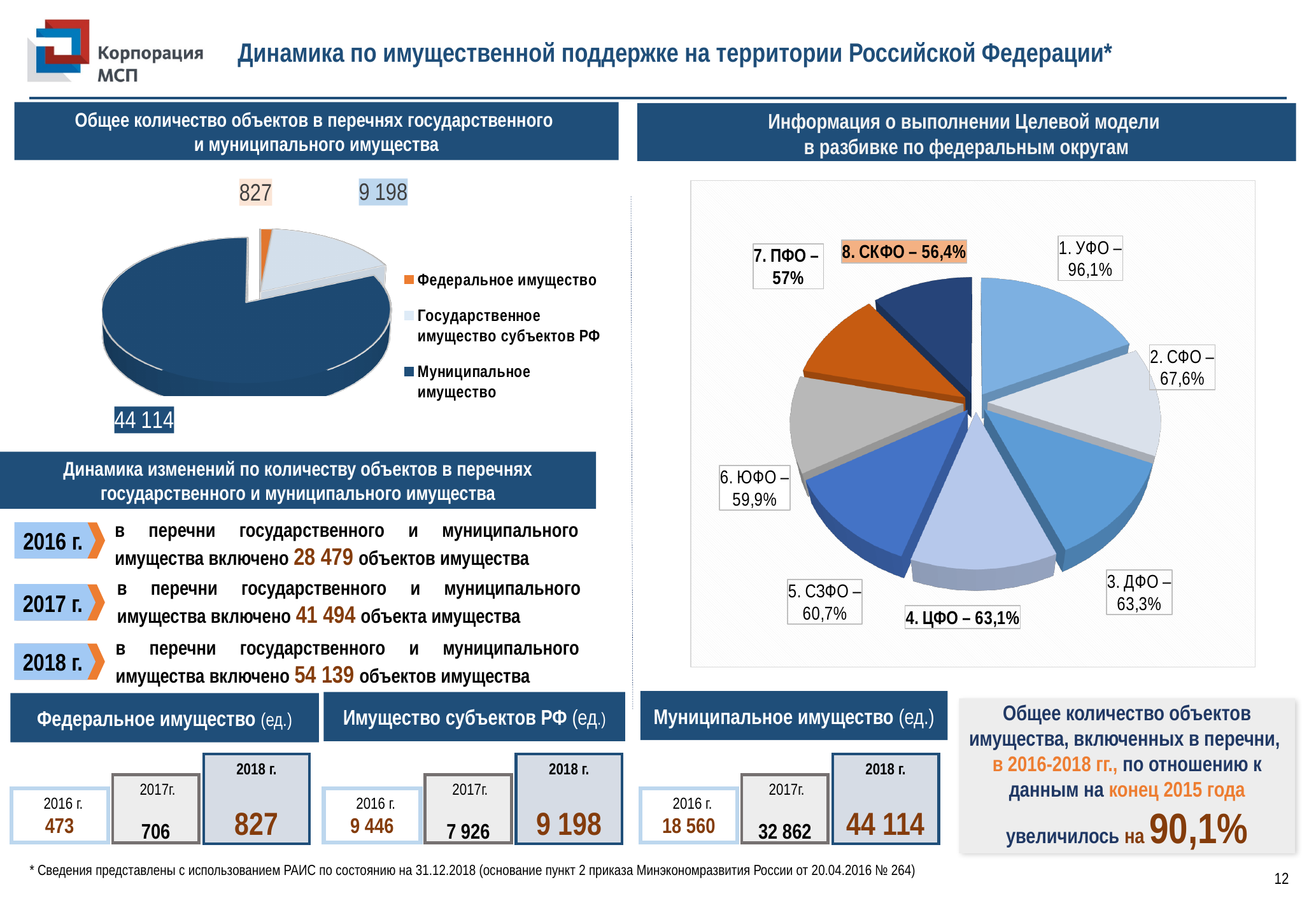
In the chart «Общее количество объектов в перечнях государственного и муниципального имущества», what is the value for «Федеральное имущество»? 827 In the chart «Общее количество объектов в перечнях государственного и муниципального имущества», what is the total of all three slices? 54 139 In the chart «Общее количество объектов в перечнях государственного и муниципального имущества», what is the value for «Муниципальное имущество»? 44 114 In the chart «Информация о выполнении Целевой модели в разбивке по федеральным округам», what is the difference between the values for СФО and ДФО? 4,3% In the chart «Общее количество объектов в перечнях государственного и муниципального имущества», which category has the largest value? Муниципальное имущество How many federal districts are shown in the chart «Информация о выполнении Целевой модели в разбивке по федеральным округам»? 8 In the chart «Информация о выполнении Целевой модели в разбивке по федеральным округам», which federal district has the lowest value? СКФО What kind of chart is the chart titled «Общее количество объектов в перечнях государственного и муниципального имущества»? Pie chart In the chart «Информация о выполнении Целевой модели в разбивке по федеральным округам», what is the value for УФО? 96,1% How many categories does the legend of the chart «Общее количество объектов в перечнях государственного и муниципального имущества» list? 3 In the chart «Информация о выполнении Целевой модели в разбивке по федеральным округам», which federal district has the highest value? УФО In the chart «Общее количество объектов в перечнях государственного и муниципального имущества», what is the difference between «Государственное имущество субъектов РФ» and «Федеральное имущество»? 8 371